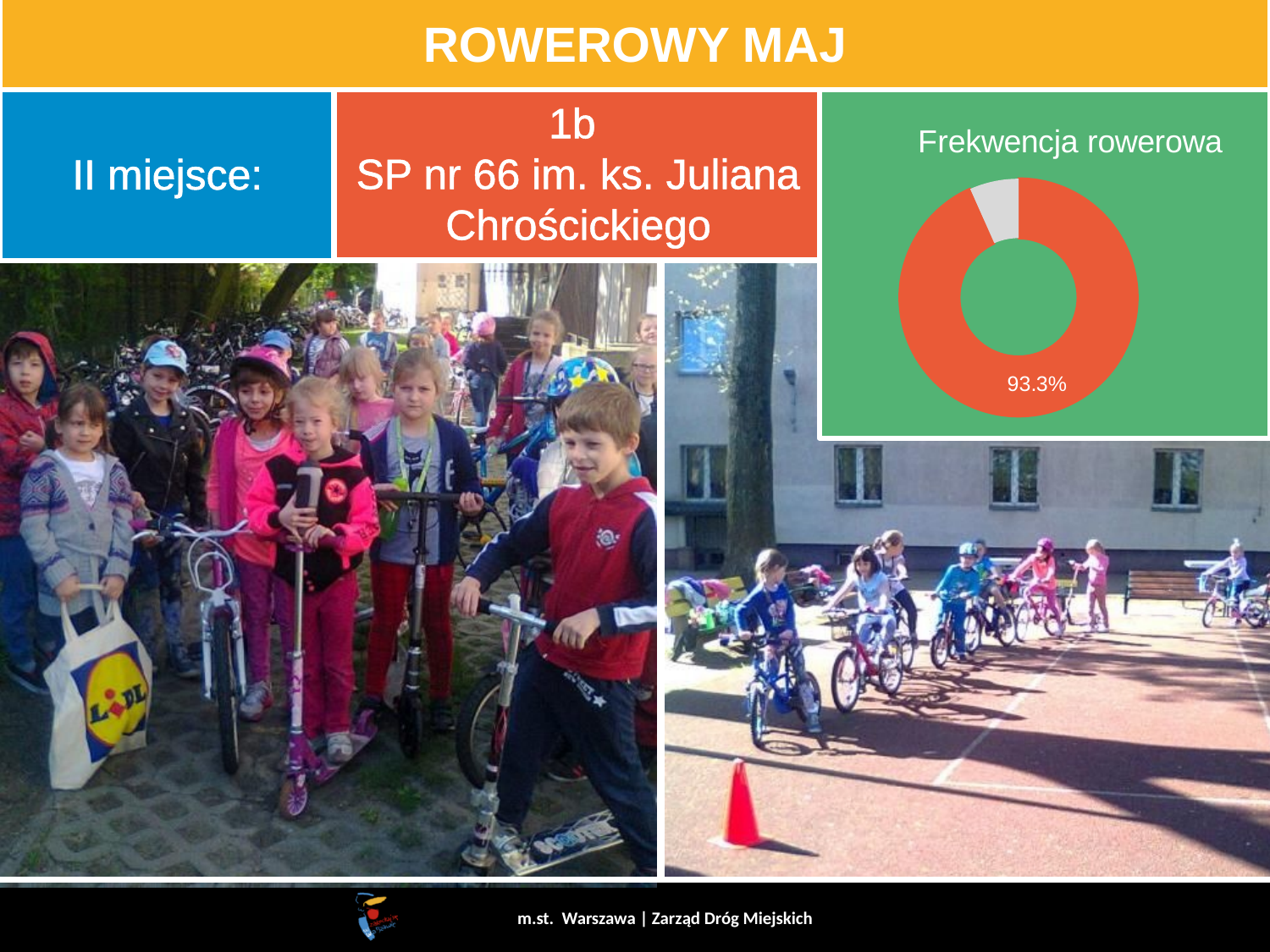
What value is printed on the large slice of the 'Frekwencja rowerowa' chart? 93.3% How many slices does the 'Frekwencja rowerowa' donut chart have? 2 What kind of chart is shown on the slide? Donut (pie) chart What is the title of the chart on the slide? Frekwencja rowerowa Which slice of the 'Frekwencja rowerowa' chart is larger, the orange one or the grey one? The orange one Is the labelled value in the 'Frekwencja rowerowa' chart greater or less than 90%? greater What colour is the slice labelled 93.3% in the 'Frekwencja rowerowa' chart? Orange How many data labels are printed on the 'Frekwencja rowerowa' chart? 1 What share of the 'Frekwencja rowerowa' donut does the orange slice represent? 93.3%